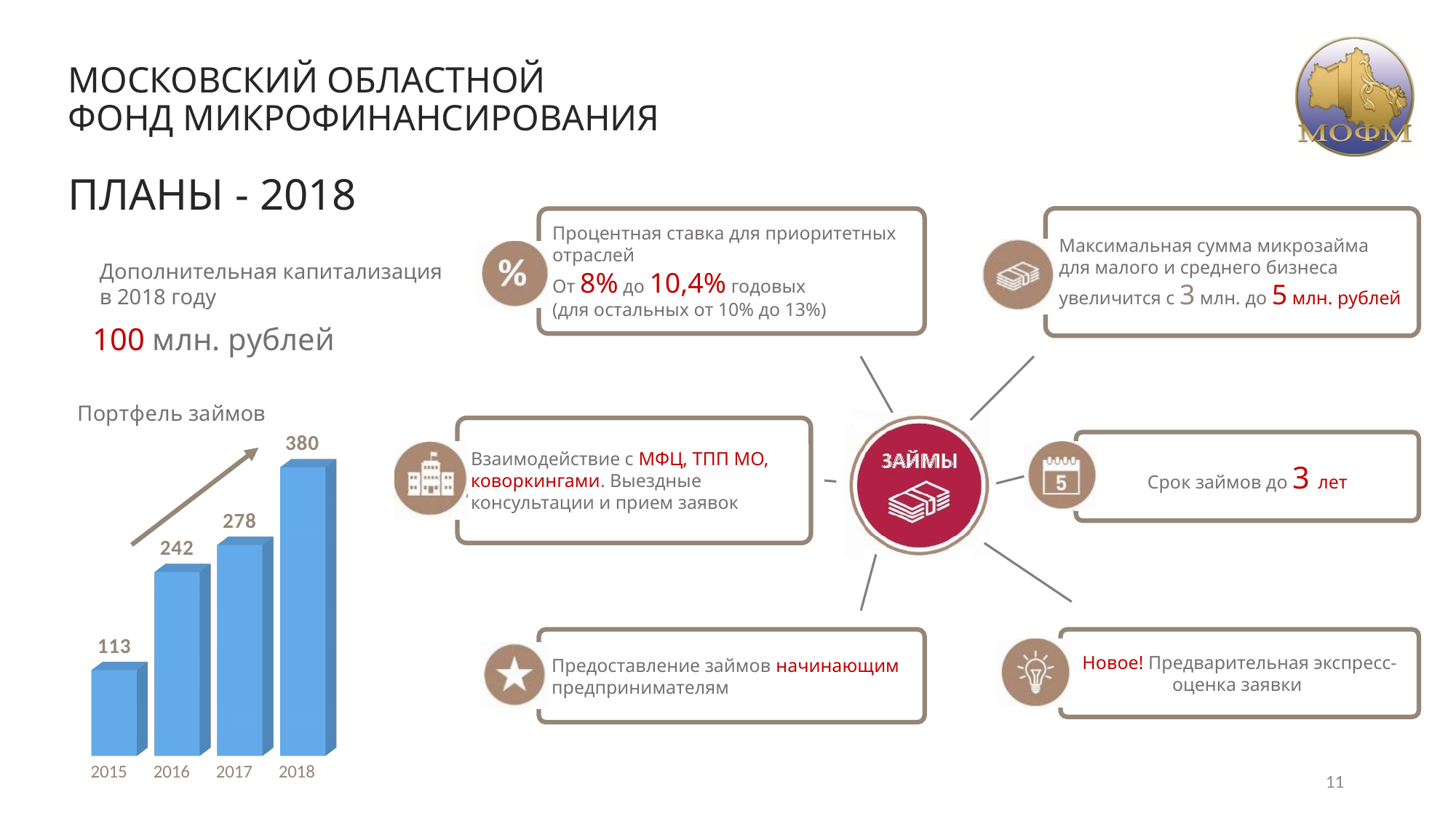
What is the value for 2015 in the 'Портфель займов' chart? 113 Which is larger in the 'Портфель займов' chart, the value for 2016 or the value for 2017? 2017 What is the value for 2018 in the 'Портфель займов' chart? 380 What is the value for 2016 in the 'Портфель займов' chart? 242 Which year has the highest value in the 'Портфель займов' chart? 2018 What is the value for 2017 in the 'Портфель займов' chart? 278 How many years are shown in the 'Портфель займов' chart? 4 Which year has the lowest value in the 'Портфель займов' chart? 2015 What kind of chart is the 'Портфель займов' chart? bar chart What is the difference between the 2016 and 2015 values in the 'Портфель займов' chart? 129 What is the difference between the 2018 and 2017 values in the 'Портфель займов' chart? 102 Do the values in the 'Портфель займов' chart rise or fall from 2015 to 2018? rise